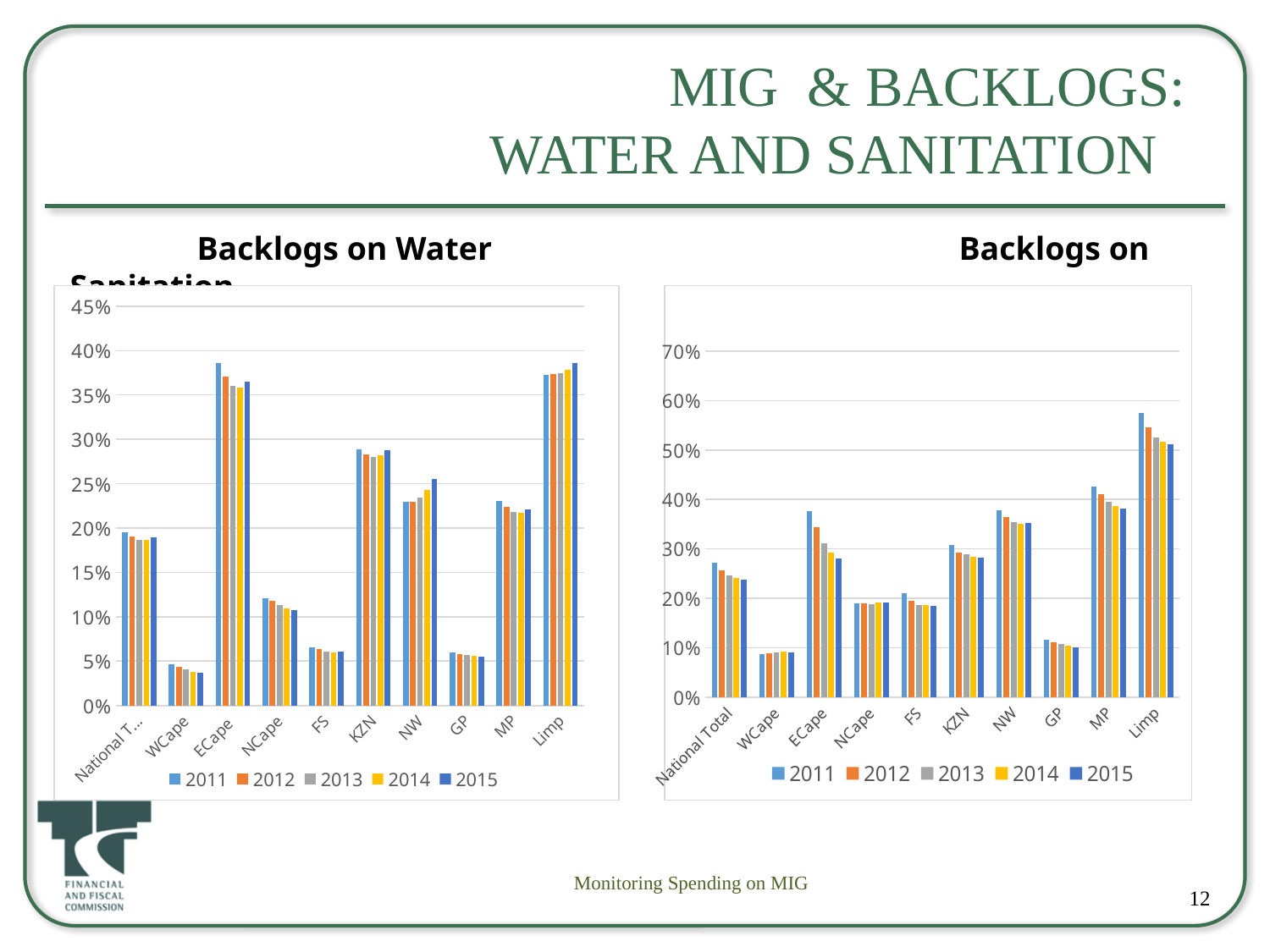
In the right-hand chart (Backlogs on Sanitation), which category has the highest 2011 value? Limp In the right-hand chart (Backlogs on Sanitation), is the 2011 value for Limp greater or less than 50%? greater In the right-hand chart (Backlogs on Sanitation), do the values for ECape rise or fall from 2011 to 2015? fall In the 'Backlogs on Water' chart, which has the larger 2011 value, ECape or KZN? ECape How many series does the legend of the 'Backlogs on Water' chart list? 5 What is the first year listed in the legend of the right-hand chart (Backlogs on Sanitation)? 2011 In the right-hand chart (Backlogs on Sanitation), which has the larger 2011 value, MP or KZN? MP In the 'Backlogs on Water' chart, do the values for NW rise or fall from 2011 to 2015? rise In the 'Backlogs on Water' chart, is the 2011 value for KZN greater or less than 25%? greater What kind of chart is the 'Backlogs on Water' chart on the left? bar chart In the 'Backlogs on Water' chart, is the 2011 value for WCape greater or less than 10%? less How many categories are shown on the x axis of the 'Backlogs on Water' chart? 10